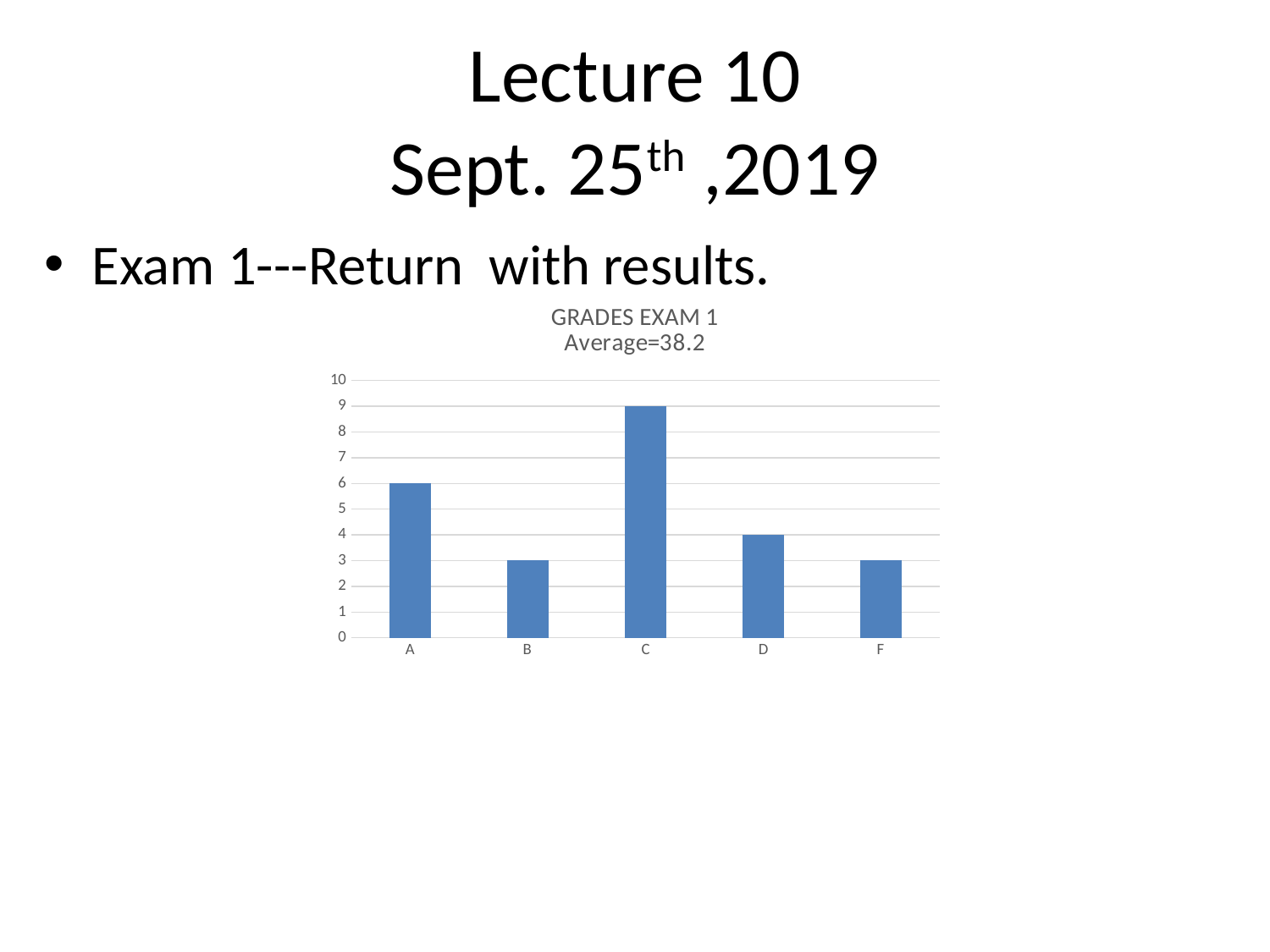
What is the difference between the values for C and A in the GRADES EXAM 1 chart? 3 What is the value for grade C in the GRADES EXAM 1 chart? 9 How many grade categories are shown on the x axis of the GRADES EXAM 1 chart? 5 What is the value for grade A in the GRADES EXAM 1 chart? 6 What average is stated in the title of the GRADES EXAM 1 chart? Average=38.2 What kind of chart is the GRADES EXAM 1 chart? bar chart Which is larger in the GRADES EXAM 1 chart, the value for A or the value for D? A Which grade has the highest bar in the GRADES EXAM 1 chart? C What is the highest value shown on the y axis of the GRADES EXAM 1 chart? 10 Is the value for C in the GRADES EXAM 1 chart greater or less than 5? greater What is the value for grade D in the GRADES EXAM 1 chart? 4 Do the values for B and F in the GRADES EXAM 1 chart have the same value, and if so what is it? Yes, 3